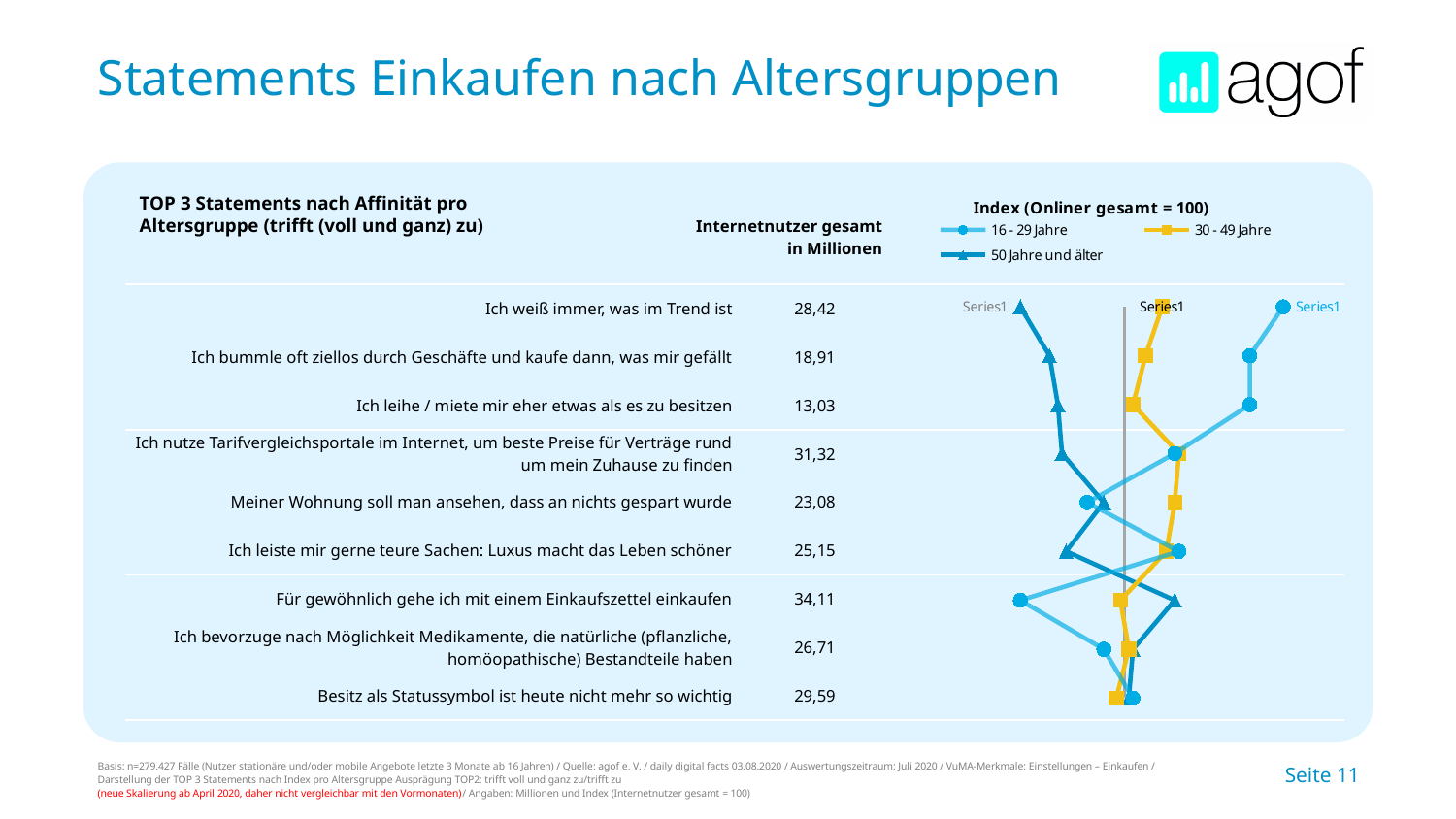
For the statement 'Für gewöhnlich gehe ich mit einem Einkaufszettel einkaufen', which age group has the higher index: 16 - 29 Jahre or 50 Jahre und älter? 50 Jahre und älter How many series does the chart legend list? 3 What kind of chart is shown on the slide? Line chart For the statement 'Ich leihe / miete mir eher etwas als es zu besitzen', which age group has the higher index: 16 - 29 Jahre or 30 - 49 Jahre? 16 - 29 Jahre What colour is used for the series '30 - 49 Jahre'? Yellow For the statement 'Ich weiß immer, was im Trend ist', which age group has the higher index: 16 - 29 Jahre or 50 Jahre und älter? 16 - 29 Jahre Which statement has the highest value in 'Internetnutzer gesamt in Millionen'? Für gewöhnlich gehe ich mit einem Einkaufszettel einkaufen Which statement has the lowest value in 'Internetnutzer gesamt in Millionen'? Ich leihe / miete mir eher etwas als es zu besitzen How many statements (categories) are plotted in the chart? 9 What is the value in 'Internetnutzer gesamt in Millionen' for the statement 'Ich weiß immer, was im Trend ist'? 28,42 Which age groups are listed in the chart legend? 16 - 29 Jahre, 30 - 49 Jahre, 50 Jahre und älter What is the value in 'Internetnutzer gesamt in Millionen' for the statement 'Besitz als Statussymbol ist heute nicht mehr so wichtig'? 29,59